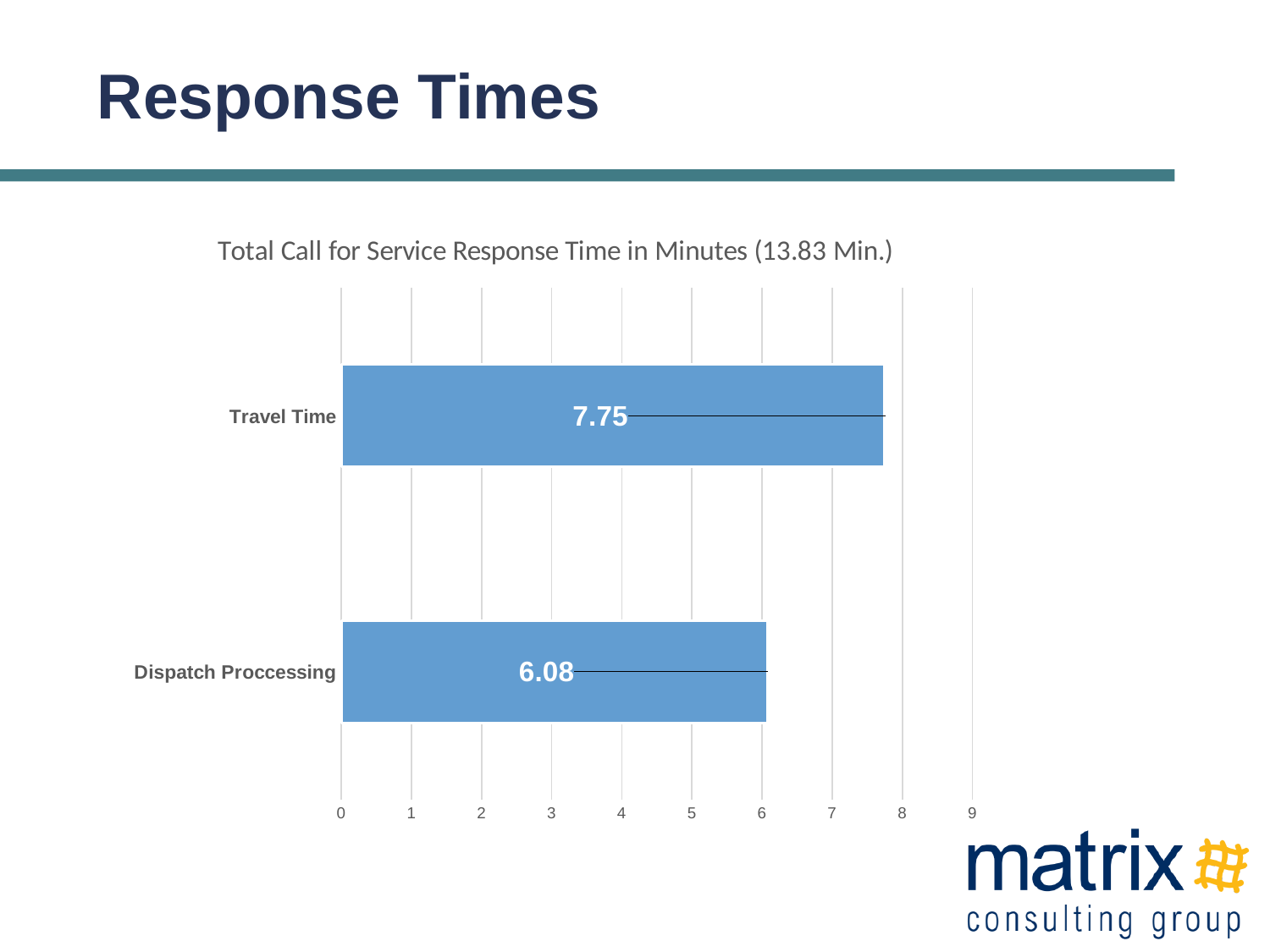
What is the title of the chart? Total Call for Service Response Time in Minutes (13.83 Min.) Is the value for Travel Time greater or less than 7? greater What kind of chart is shown on the slide? bar chart What is the difference between the Travel Time and Dispatch Proccessing values? 1.67 How many categories are shown in the chart? 2 What is the value for Dispatch Proccessing? 6.08 Which category has the highest value? Travel Time Which category has the lowest value? Dispatch Proccessing What is the highest value shown on the x axis? 9 Is the value for Dispatch Proccessing greater or less than 7? less Which is larger, Travel Time or Dispatch Proccessing? Travel Time What is the value for Travel Time? 7.75